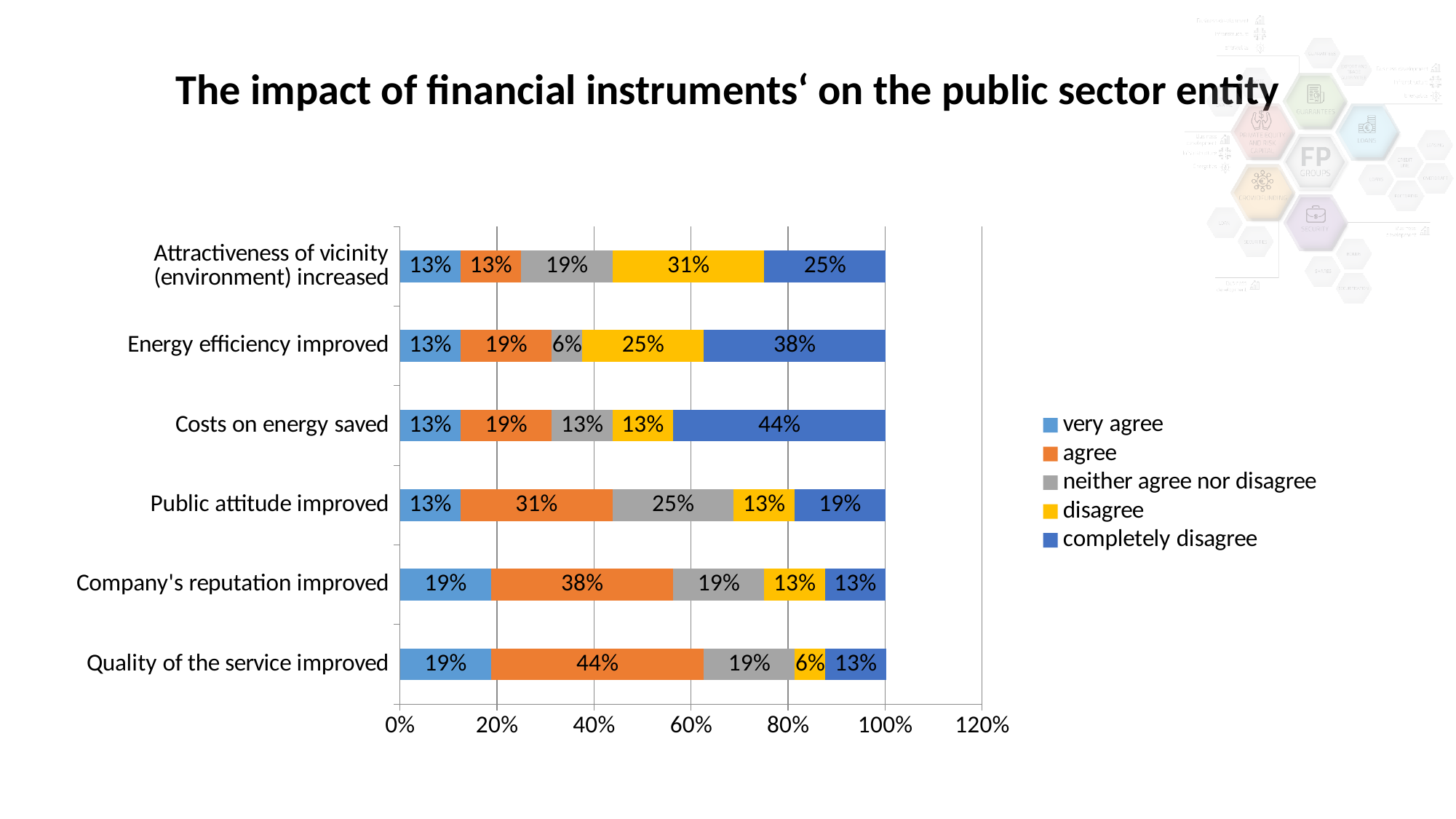
Which category has the highest 'completely disagree' value? Costs on energy saved What percentage of respondents 'completely disagree' that costs on energy were saved? 44% What is the 'disagree' value for 'Attractiveness of vicinity (environment) increased'? 31% What is the difference between the 'agree' values for 'Quality of the service improved' and 'Company's reputation improved'? 6% Which colour represents 'disagree' in the legend? Yellow What is the 'neither agree nor disagree' value for 'Energy efficiency improved'? 6% How many categories are shown on the y axis? 6 How many series does the legend list? 5 Which category has the lowest 'agree' value? Attractiveness of vicinity (environment) increased What is the 'agree' value for 'Quality of the service improved'? 44% What kind of chart is shown on the slide? Stacked bar chart Which is larger: the 'completely disagree' value for 'Energy efficiency improved' or for 'Public attitude improved'? Energy efficiency improved